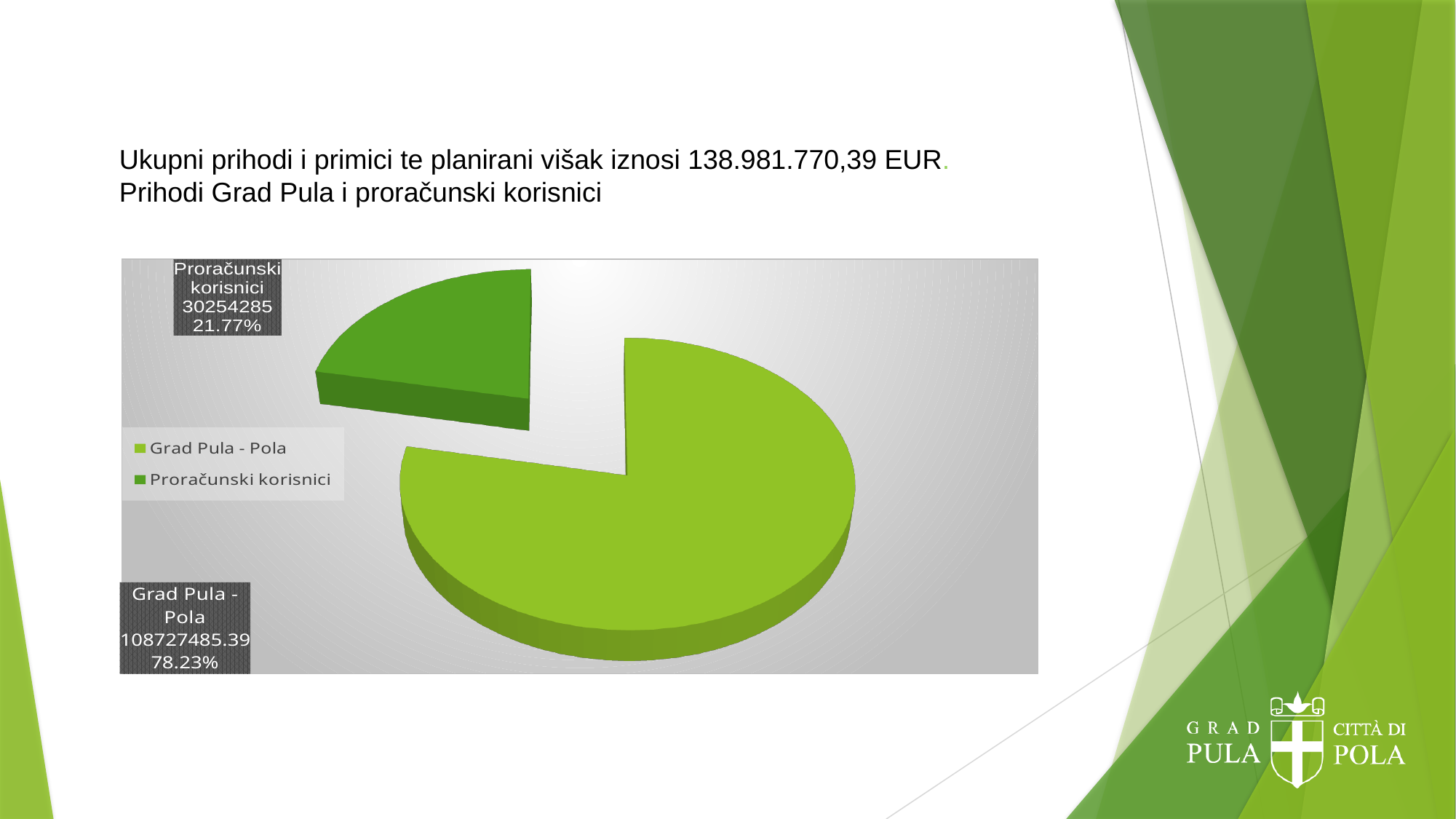
Which legend entry is shown in the darker green colour? Proračunski korisnici What is the difference between the values for Grad Pula - Pola and Proračunski korisnici? 78473200.39 What is the value for Proračunski korisnici? 30254285 How many entries does the legend list? 2 Which slice is the smallest? Proračunski korisnici How many slices does the pie chart have? 2 What share of the pie does Proračunski korisnici represent? 21.77% What is the value for Grad Pula - Pola? 108727485.39 Which slice is the largest? Grad Pula - Pola Which is larger, Grad Pula - Pola or Proračunski korisnici? Grad Pula - Pola What kind of chart is shown on the slide? pie chart What share of the pie does Grad Pula - Pola represent? 78.23%